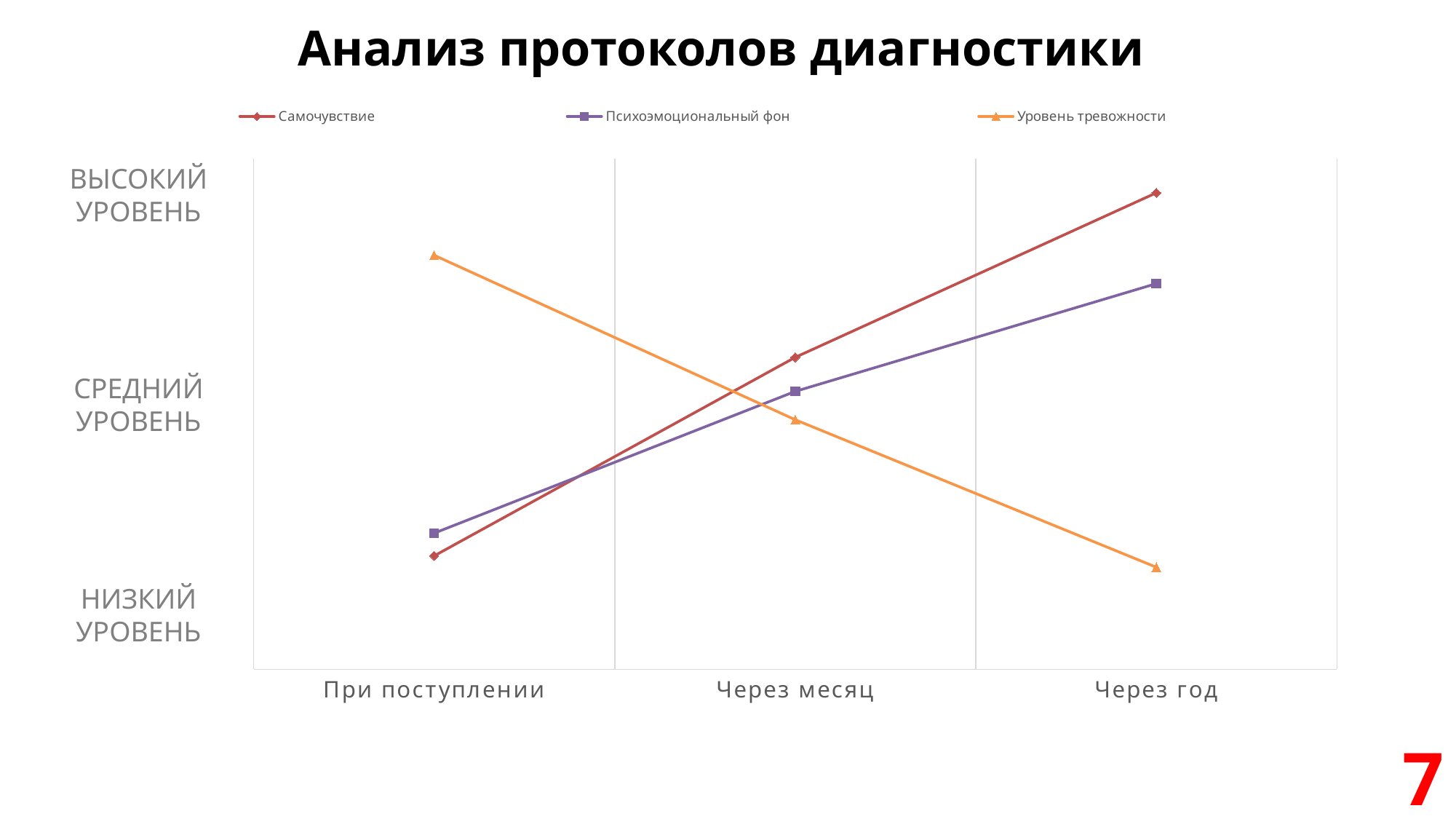
Does the Психоэмоциональный фон series rise or fall along the x axis? Rises Does the Самочувствие series rise or fall from При поступлении to Через год? Rises At При поступлении, which series has the highest value? Уровень тревожности What kind of chart is shown on the slide? Line chart Does the Уровень тревожности series rise or fall from При поступлении to Через год? Falls At which category is the Уровень тревожности series lowest? Через год At Через год, which is higher: Самочувствие or Психоэмоциональный фон? Самочувствие How many categories are shown on the x axis? 3 What is the title of the chart? Анализ протоколов диагностики Which series is drawn in orange with triangle markers? Уровень тревожности How many series does the legend list? 3 At which category is the Самочувствие series highest? Через год